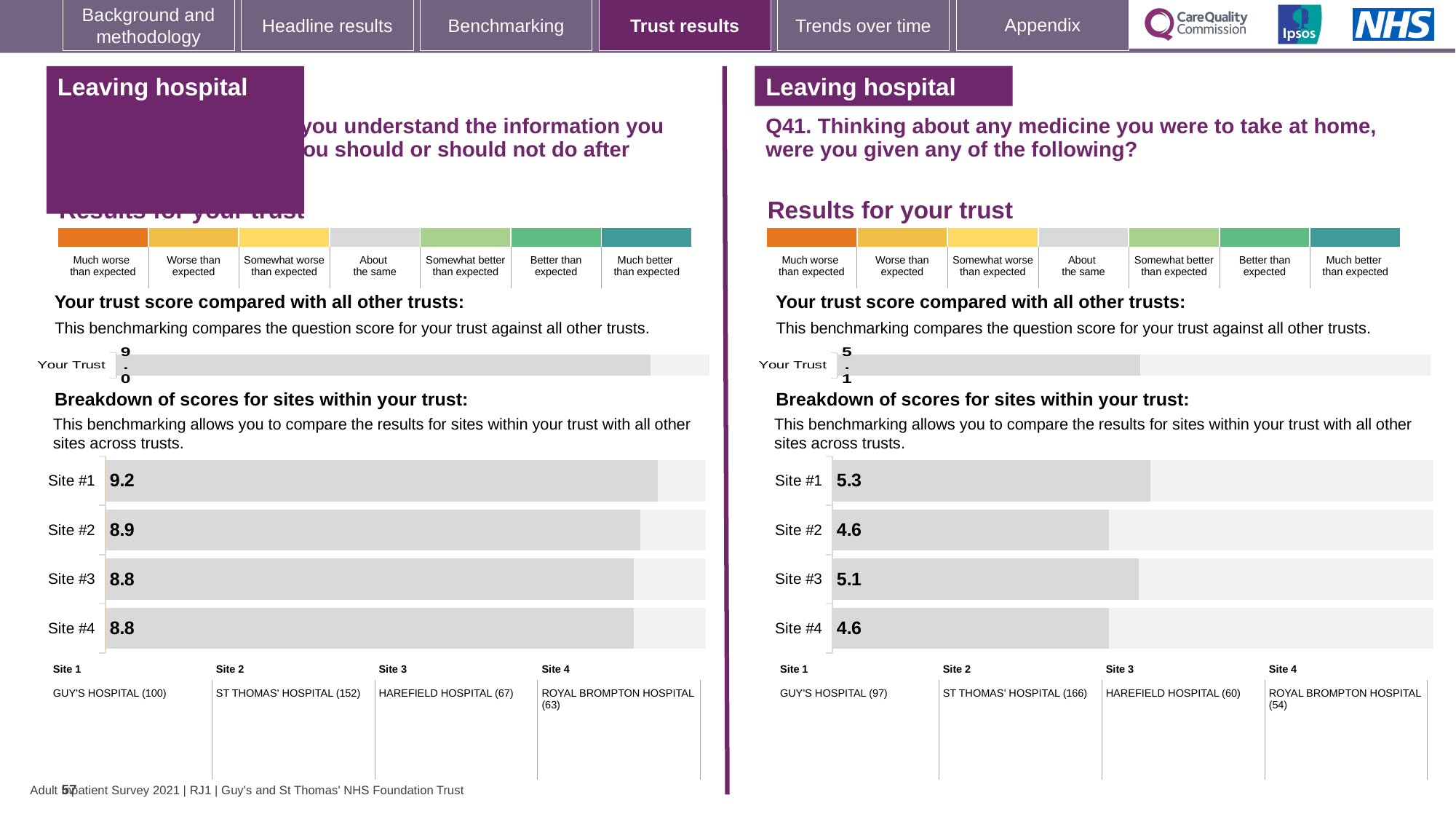
In the Q41 'Your trust score compared with all other trusts' chart on the right, what is the score for Your Trust? 5.1 In the left-hand site breakdown chart, what is the difference between the scores for Site #1 and Site #2? 0.3 In the Q41 site breakdown chart on the right, what is the difference between the scores for Site #1 and Site #2? 0.7 In the left-hand 'Your trust score compared with all other trusts' chart, what is the score for Your Trust? 9.0 In the Q41 site breakdown chart on the right, what is the score for Site #3? 5.1 In the left-hand site breakdown chart, what is the score for Site #2? 8.9 In the left-hand site breakdown chart, what is the score for Site #1? 9.2 In the left-hand site breakdown chart, which site has the highest score? Site #1 In the Q41 site breakdown chart on the right, which site has the highest score? Site #1 What kind of chart is the Q41 site breakdown chart on the right? Bar chart In the Q41 site breakdown chart on the right, what is the score for Site #1? 5.3 In the left-hand site breakdown chart, how many sites are shown? 4